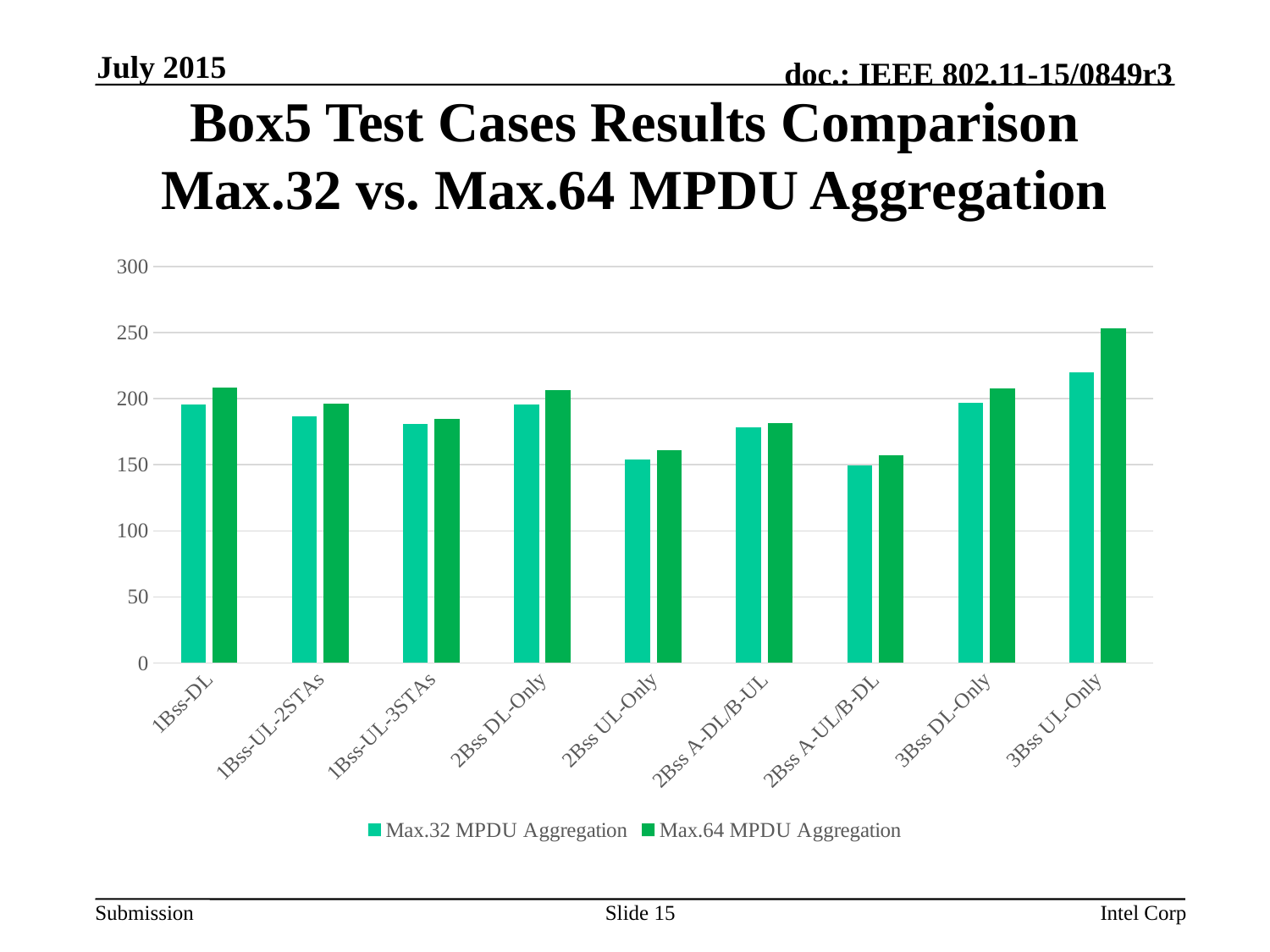
Which category has the highest value for Max.64 MPDU Aggregation? 3Bss UL-Only How many series does the legend list? 2 Is the Max.64 MPDU Aggregation value for 2Bss UL-Only greater or less than 200? less Which category has the lowest value for Max.32 MPDU Aggregation? 2Bss A-UL/B-DL How many test-case categories are shown on the x axis? 9 Which is larger for Max.32 MPDU Aggregation: 1Bss-DL or 2Bss UL-Only? 1Bss-DL What are the two series named in the legend? Max.32 MPDU Aggregation and Max.64 MPDU Aggregation What kind of chart is shown on the slide? bar chart For 3Bss UL-Only, which series has the larger value, Max.32 MPDU Aggregation or Max.64 MPDU Aggregation? Max.64 MPDU Aggregation Which category has the highest value for Max.32 MPDU Aggregation? 3Bss UL-Only Is the Max.32 MPDU Aggregation value for 1Bss-UL-3STAs greater or less than 200? less Is the Max.32 MPDU Aggregation value for 3Bss UL-Only greater or less than 200? greater